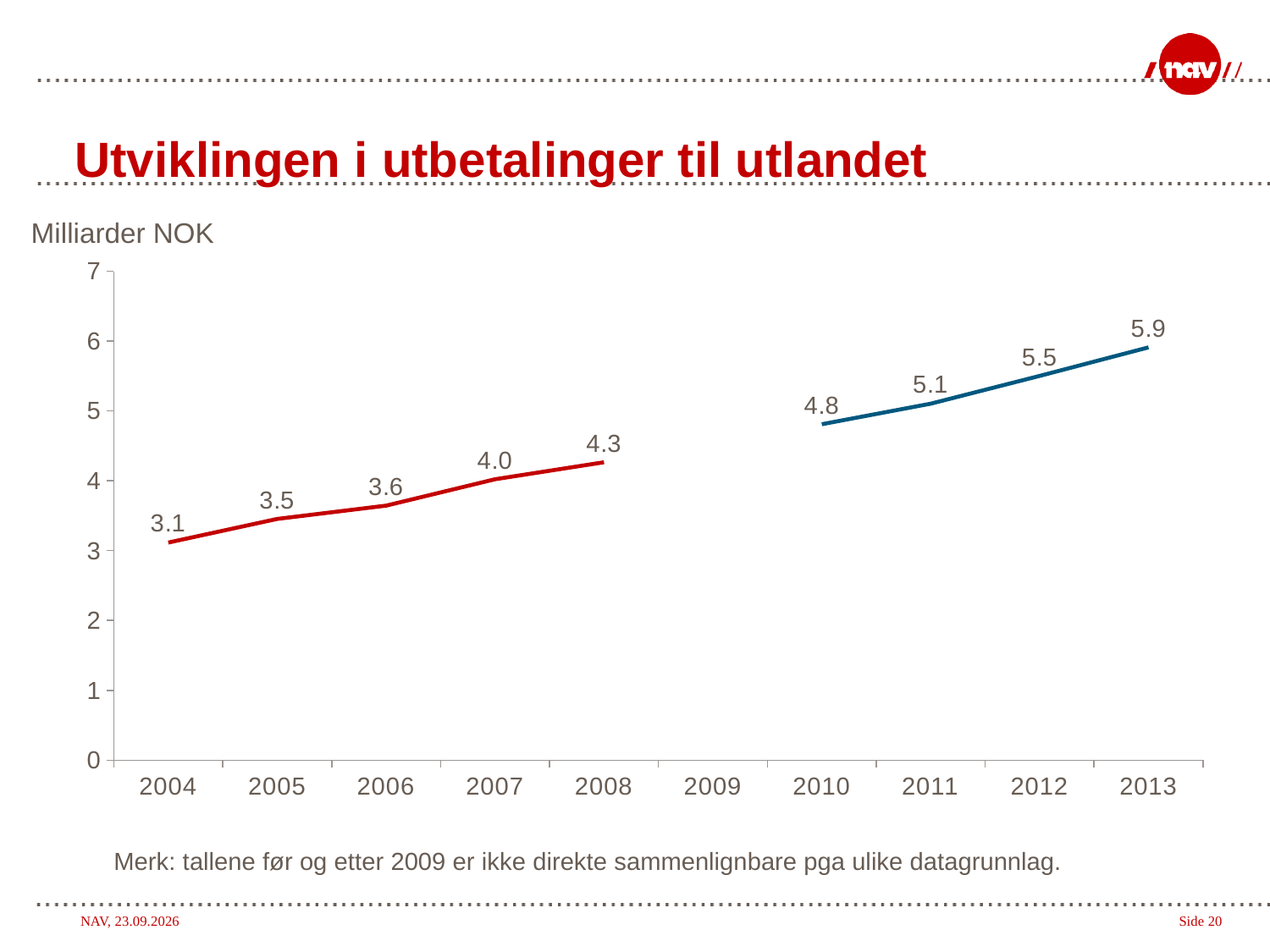
Do the values rise or fall from 2010 to 2013? rise What is the value for 2004? 3.1 What is the value for 2013? 5.9 Which year on the x axis has no data point plotted? 2009 Which year has the highest value? 2013 Which is larger, the value for 2007 or the value for 2012? 2012 What is the difference between the values for 2013 and 2010? 1.1 What is the value for 2008? 4.3 What is the value for 2011? 5.1 What kind of chart is shown? line chart What is the difference between the values for 2008 and 2004? 1.2 Which year has the lowest value? 2004